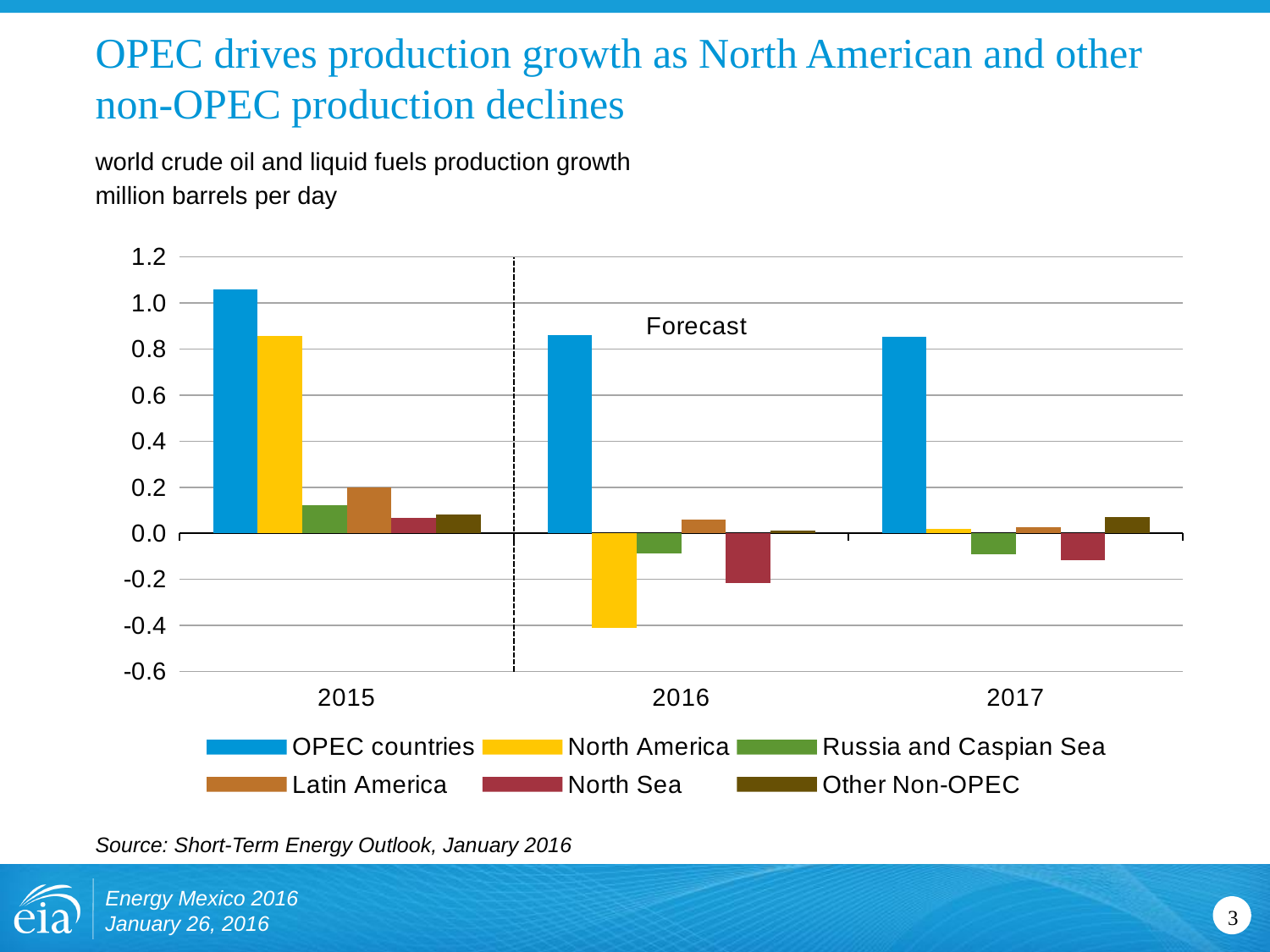
Is the value for North Sea in 2016 greater or less than 0.0? less How many years are shown on the x axis? 3 Which series has the highest production growth in 2015? OPEC countries Is the value for OPEC countries in 2015 greater or less than 1.0? greater Which series has the lowest production growth in 2016? North America Which is larger in 2015, Latin America or Russia and Caspian Sea? Latin America Which series has the highest production growth in 2017? OPEC countries Which years are in the Forecast section of the chart? 2016 and 2017 How many series does the legend list? 6 Which is larger, the OPEC countries value in 2015 or in 2016? 2015 What kind of chart is shown on the slide? bar chart Is the value for North America in 2016 greater or less than -0.2? less